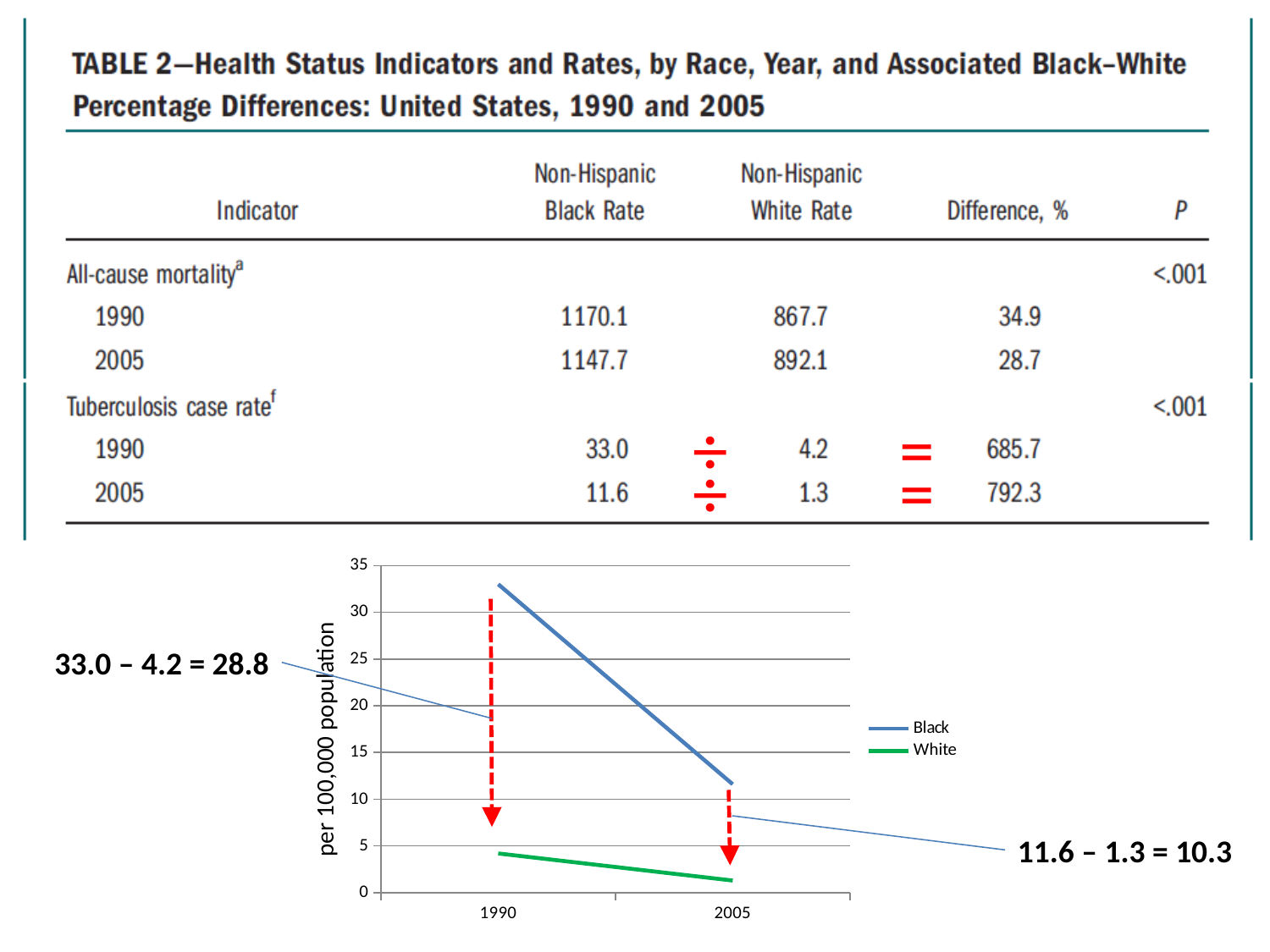
Is the value for White in 1990 greater or less than 5? less How many years are plotted along the x axis of the chart? 2 Does the White series rise or fall from 1990 to 2005? fall Does the Black series rise or fall from 1990 to 2005? fall According to the annotation on the chart, what is the difference between the Black and White values in 1990? 28.8 Is the value for Black in 2005 greater or less than 15? less In 1990, which series has the higher value, Black or White? Black What are the two series named in the chart's legend? Black and White Is the value for Black in 1990 greater or less than 30? greater How many series does the chart's legend list? 2 What kind of chart is shown on the slide? line chart According to the annotation on the chart, what is the difference between the Black and White values in 2005? 10.3